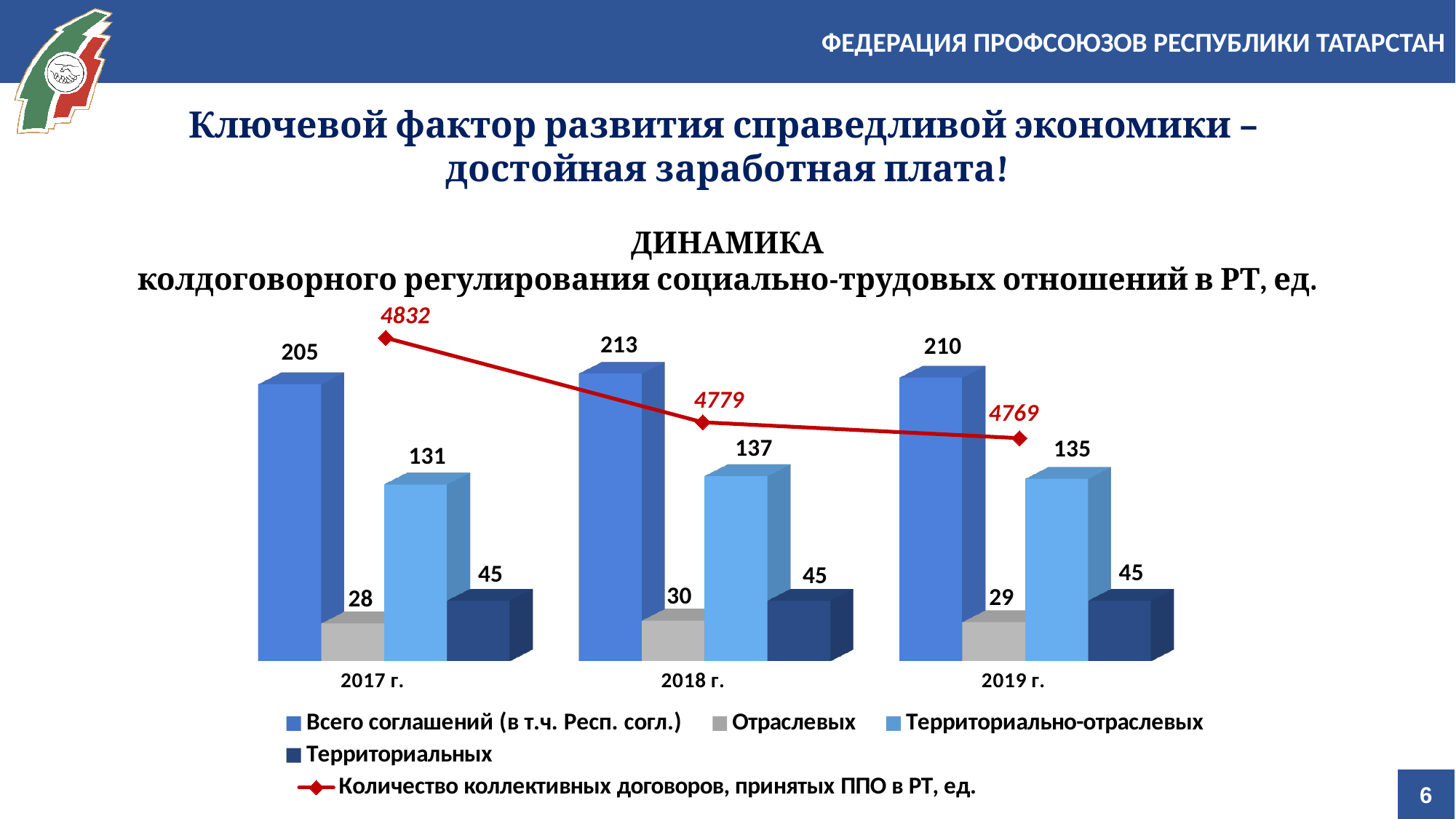
What is the value of 'Отраслевых' for 2017 г.? 28 What is the value of 'Количество коллективных договоров, принятых ППО в РТ, ед.' for 2017 г.? 4832 How many series does the legend list? 5 What is the value of 'Всего соглашений (в т.ч. Респ. согл.)' for 2018 г.? 213 In which year is 'Всего соглашений (в т.ч. Респ. согл.)' highest? 2018 г. What kind of chart is this? Combined bar and line chart How many years are shown on the x axis? 3 What is the difference between 'Территориально-отраслевых' in 2018 г. and 2017 г.? 6 What is the value of 'Территориально-отраслевых' for 2019 г.? 135 In which year is 'Количество коллективных договоров, принятых ППО в РТ, ед.' lowest? 2019 г. Does the line 'Количество коллективных договоров, принятых ППО в РТ, ед.' rise or fall from 2017 г. to 2019 г.? Fall Which is larger: 'Отраслевых' in 2018 г. or 'Отраслевых' in 2019 г.? 2018 г.